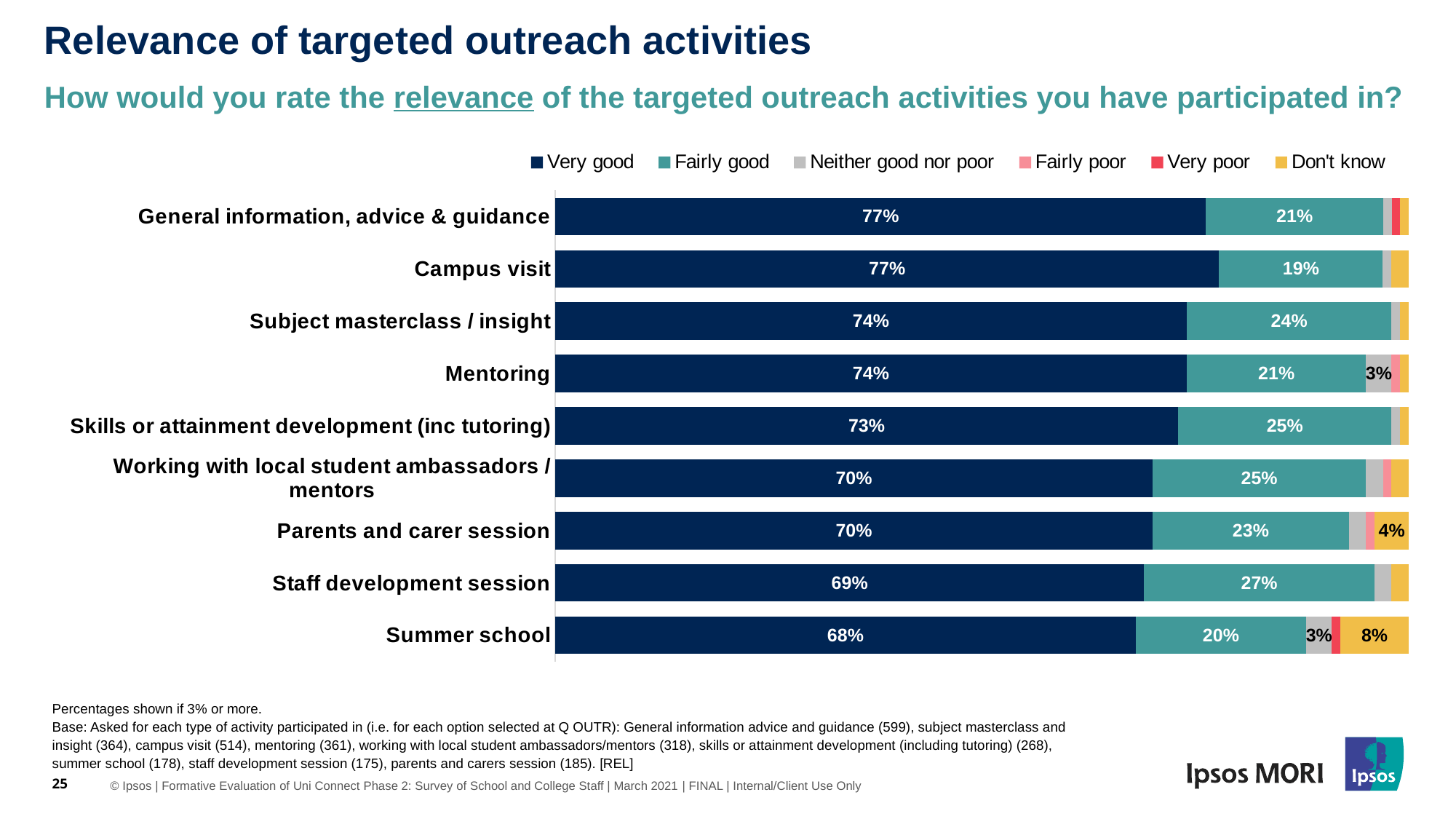
Which activity has the highest 'Fairly good' percentage? Staff development session How many rating categories does the legend list? 6 Which activity has the lowest 'Fairly good' percentage? Campus visit What is the difference between the 'Very good' percentages for General information, advice & guidance and Summer school? 9 percentage points What percentage rated Mentoring as 'Neither good nor poor'? 3% What percentage rated Staff development session as 'Fairly good'? 27% How many outreach activities are shown in the chart? 9 What type of chart is shown on the slide? Stacked bar chart What is the 'Don't know' percentage for Summer school? 8% What percentage rated the relevance of Campus visit as 'Very good'? 77% Which has a higher 'Fairly good' percentage: Subject masterclass / insight or Parents and carer session? Subject masterclass / insight Which activity has the lowest 'Very good' percentage? Summer school